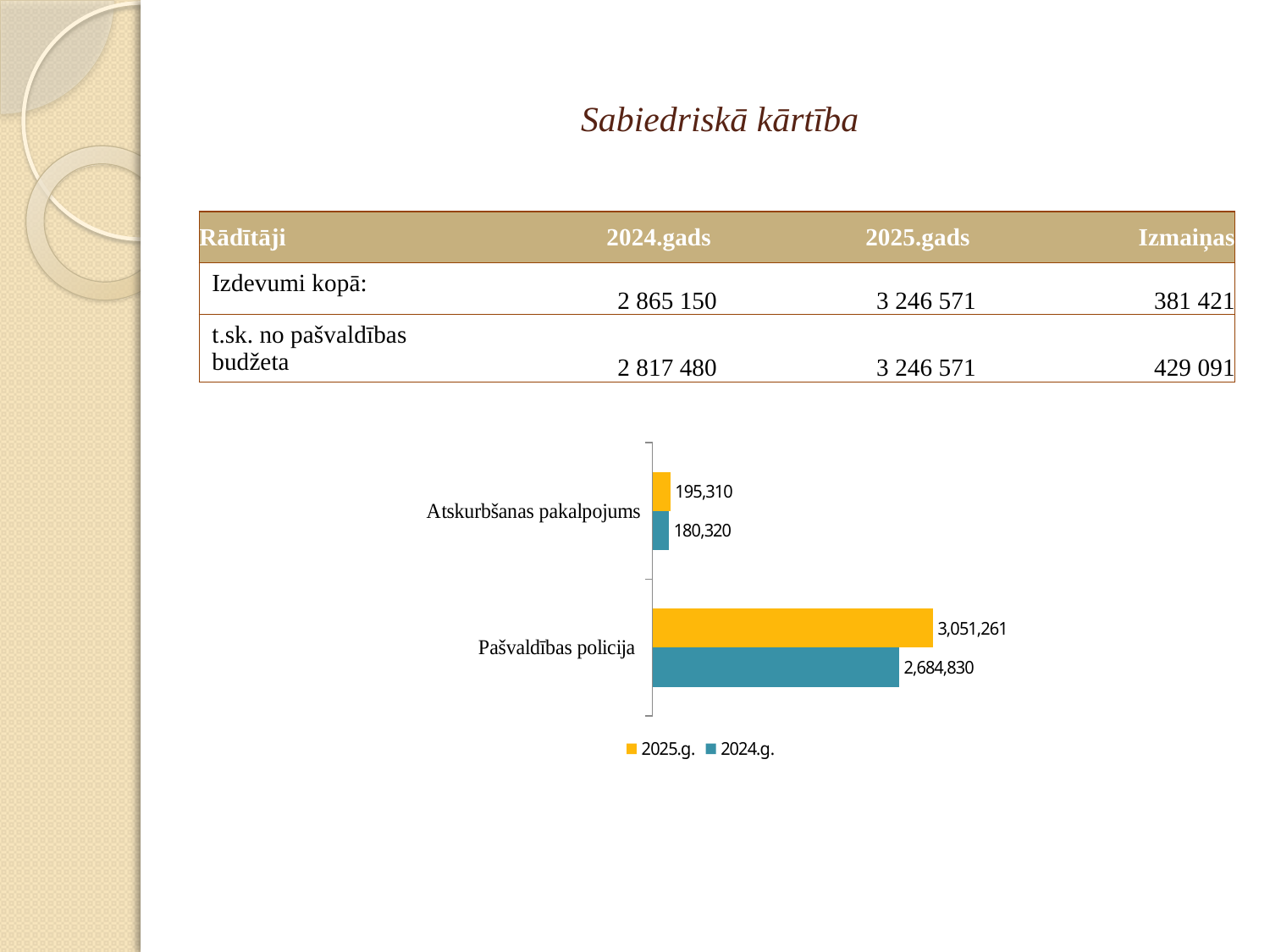
What is the value for Pašvaldības policija in the 2024.g. series? 2,684,830 How many categories are shown in the chart? 2 What kind of chart is shown on the slide? Bar chart How many series does the chart legend list? 2 For Atskurbšanas pakalpojums, which series has the larger value, 2025.g. or 2024.g.? 2025.g. Which category has the highest value in the 2025.g. series? Pašvaldības policija Which category has the lowest value in the 2024.g. series? Atskurbšanas pakalpojums What is the value for Pašvaldības policija in the 2025.g. series? 3,051,261 What is the difference between the 2025.g. and 2024.g. values for Pašvaldības policija? 366,431 What is the value for Atskurbšanas pakalpojums in the 2024.g. series? 180,320 What is the difference between the 2025.g. and 2024.g. values for Atskurbšanas pakalpojums? 14,990 What is the value for Atskurbšanas pakalpojums in the 2025.g. series? 195,310